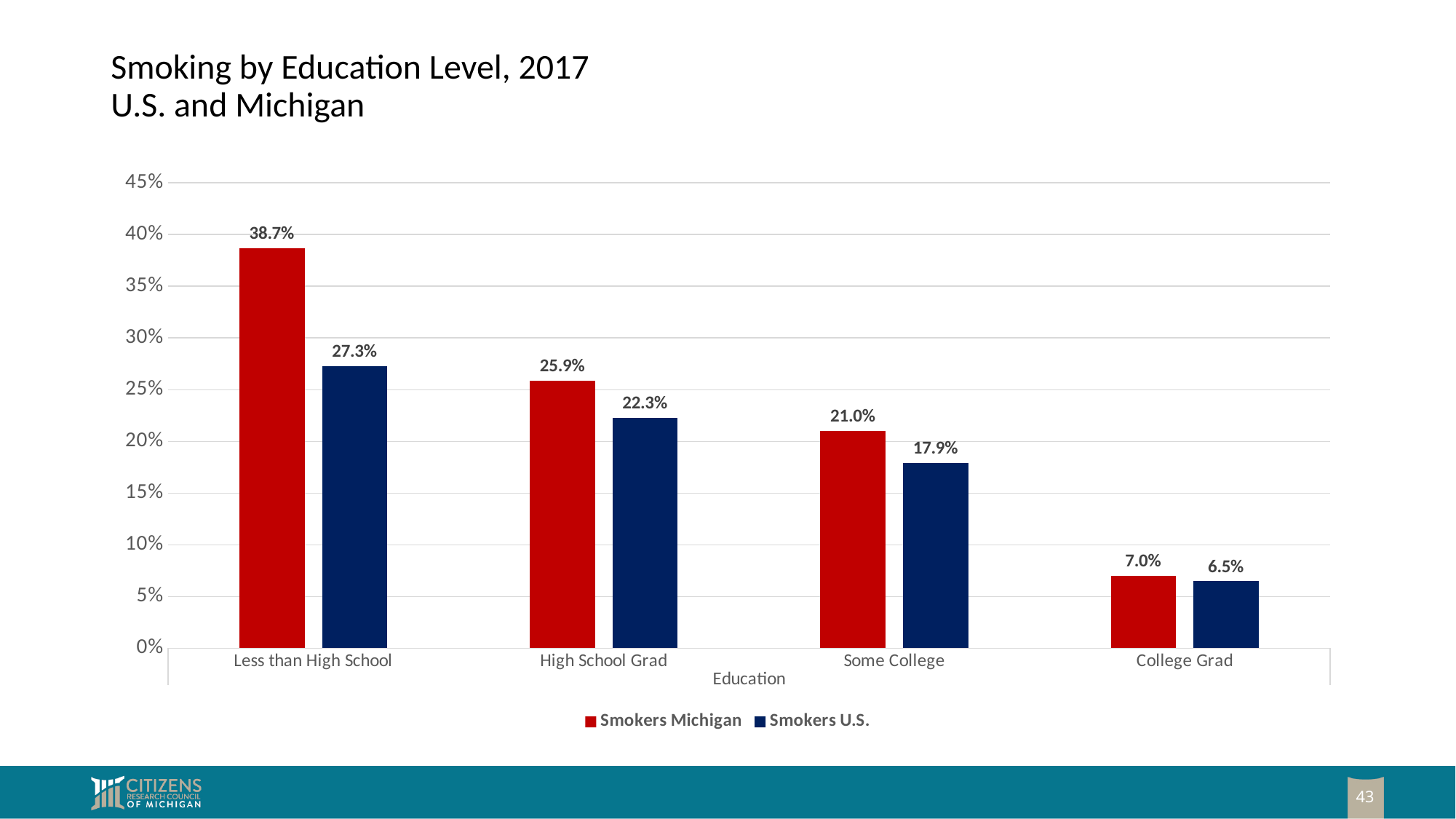
How many series does the legend list? 2 What is the smoking rate for Smokers Michigan in the Less than High School category? 38.7% What is the difference between the Smokers Michigan and Smokers U.S. values for Less than High School? 11.4% What kind of chart is shown on the slide? Bar chart For Some College, which is larger: Smokers Michigan or Smokers U.S.? Smokers Michigan What is the smoking rate for Smokers U.S. in the Some College category? 17.9% What is the smoking rate for Smokers U.S. among College Grads? 6.5% Which education category has the lowest Smokers U.S. value? College Grad Which education category has the highest Smokers Michigan value? Less than High School Do the Smokers Michigan values rise or fall as education level increases from Less than High School to College Grad? Fall What is the difference between the Smokers Michigan and Smokers U.S. values for High School Grad? 3.6% How many education categories are shown on the x axis? 4